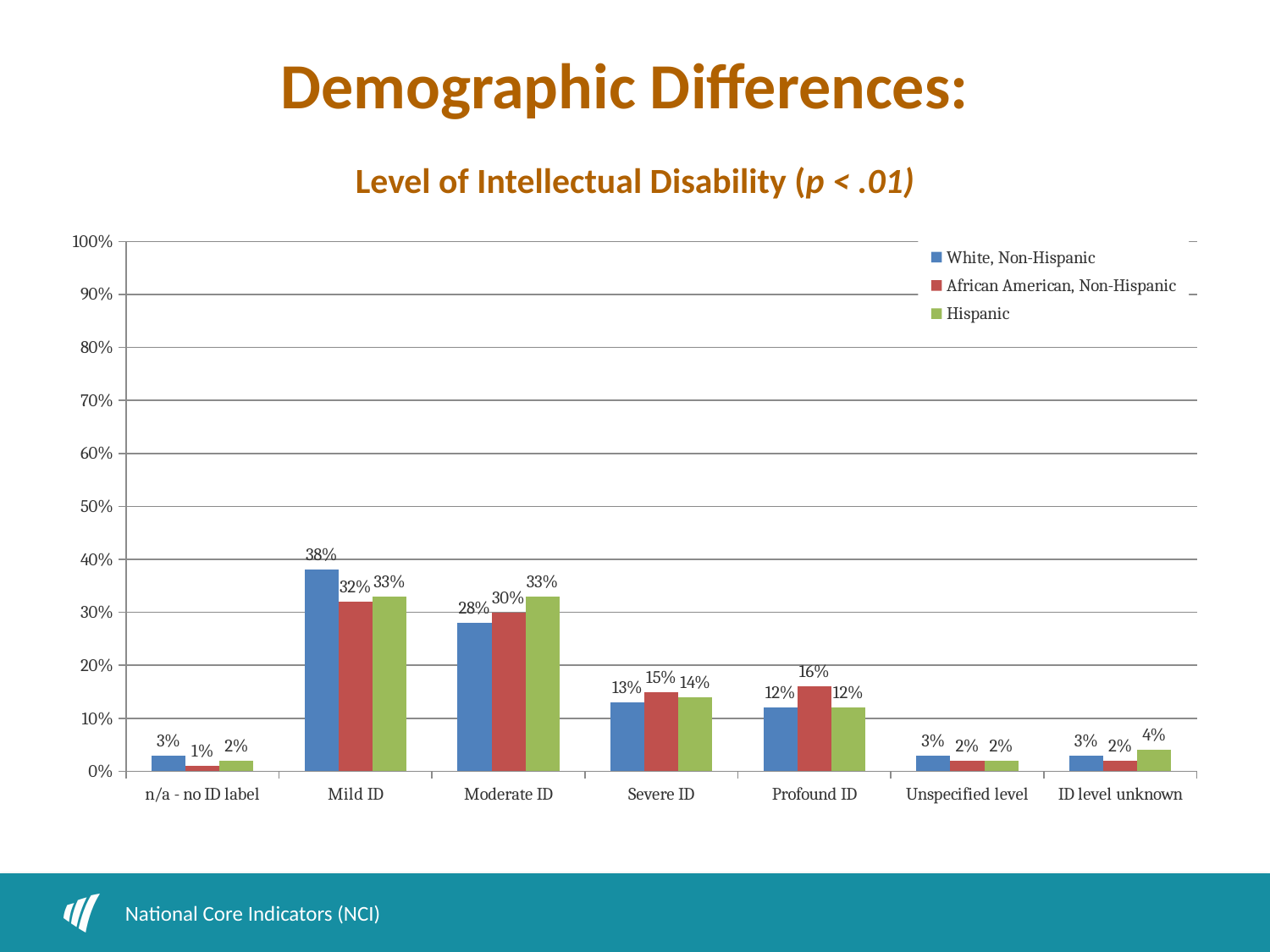
In the Severe ID category, which series has the larger value: White, Non-Hispanic or African American, Non-Hispanic? African American, Non-Hispanic What is the value for White, Non-Hispanic in the Mild ID category? 38% How many categories are shown on the x axis? 7 What kind of chart is shown on the slide? Bar chart Which series is shown in green in the legend? Hispanic What is the value for Hispanic in the ID level unknown category? 4% Which category has the highest value for the White, Non-Hispanic series? Mild ID What is the value for Hispanic in the Moderate ID category? 33% How many series does the legend list? 3 What is the value for African American, Non-Hispanic in the Profound ID category? 16% Which category has the lowest value for the African American, Non-Hispanic series? n/a - no ID label What is the difference between the White, Non-Hispanic and African American, Non-Hispanic values in the Mild ID category? 6%